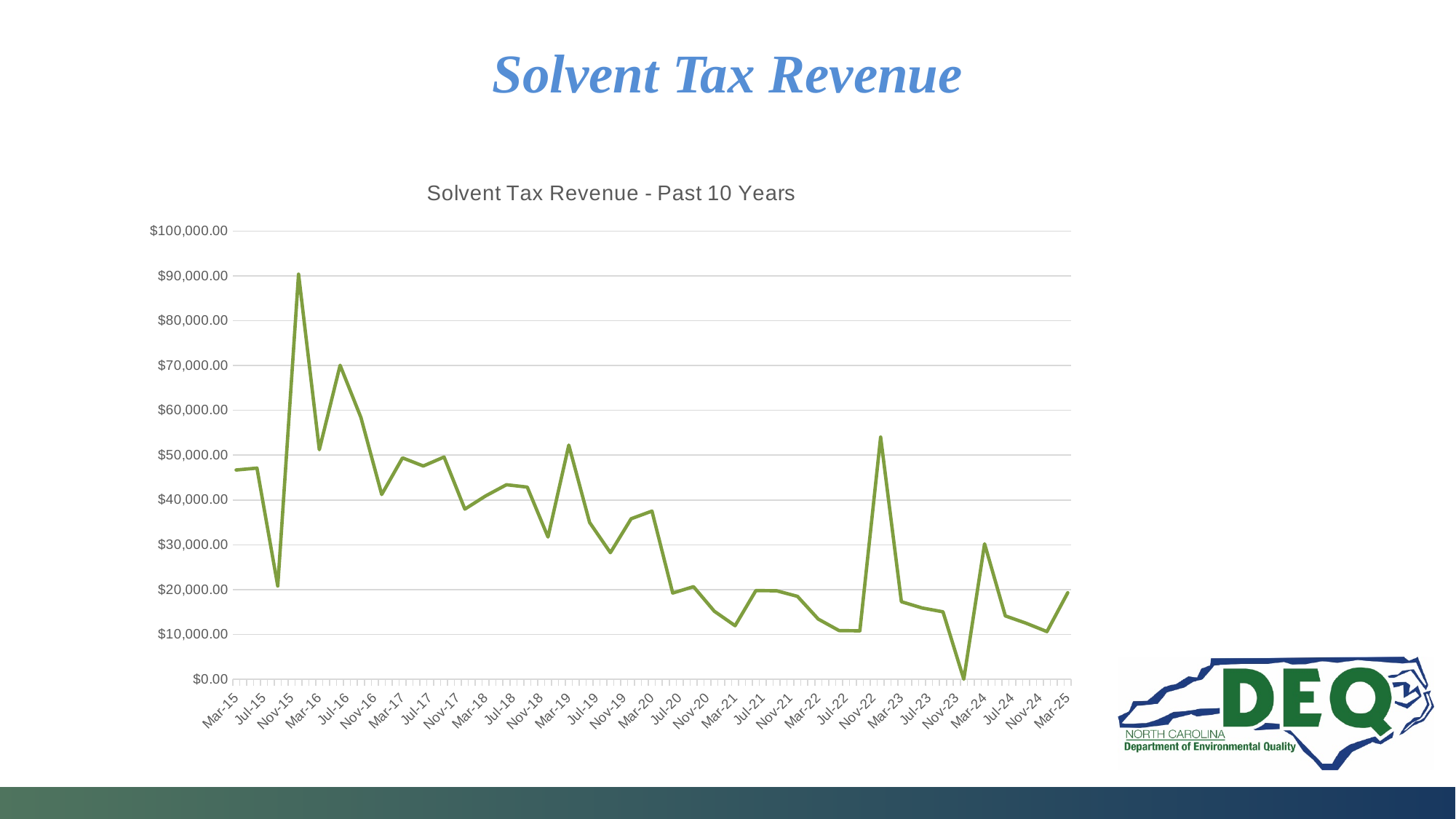
Is the value for Mar-15 greater or less than $40,000.00? greater What kind of chart is shown on the slide? line chart Which is larger, the value for Mar-15 or the value for Mar-25? Mar-15 Overall, do the solvent tax revenue values rise or fall from Mar-15 to Mar-25? fall What is the title of the chart? Solvent Tax Revenue - Past 10 Years Is the value for Mar-25 greater or less than $30,000.00? less